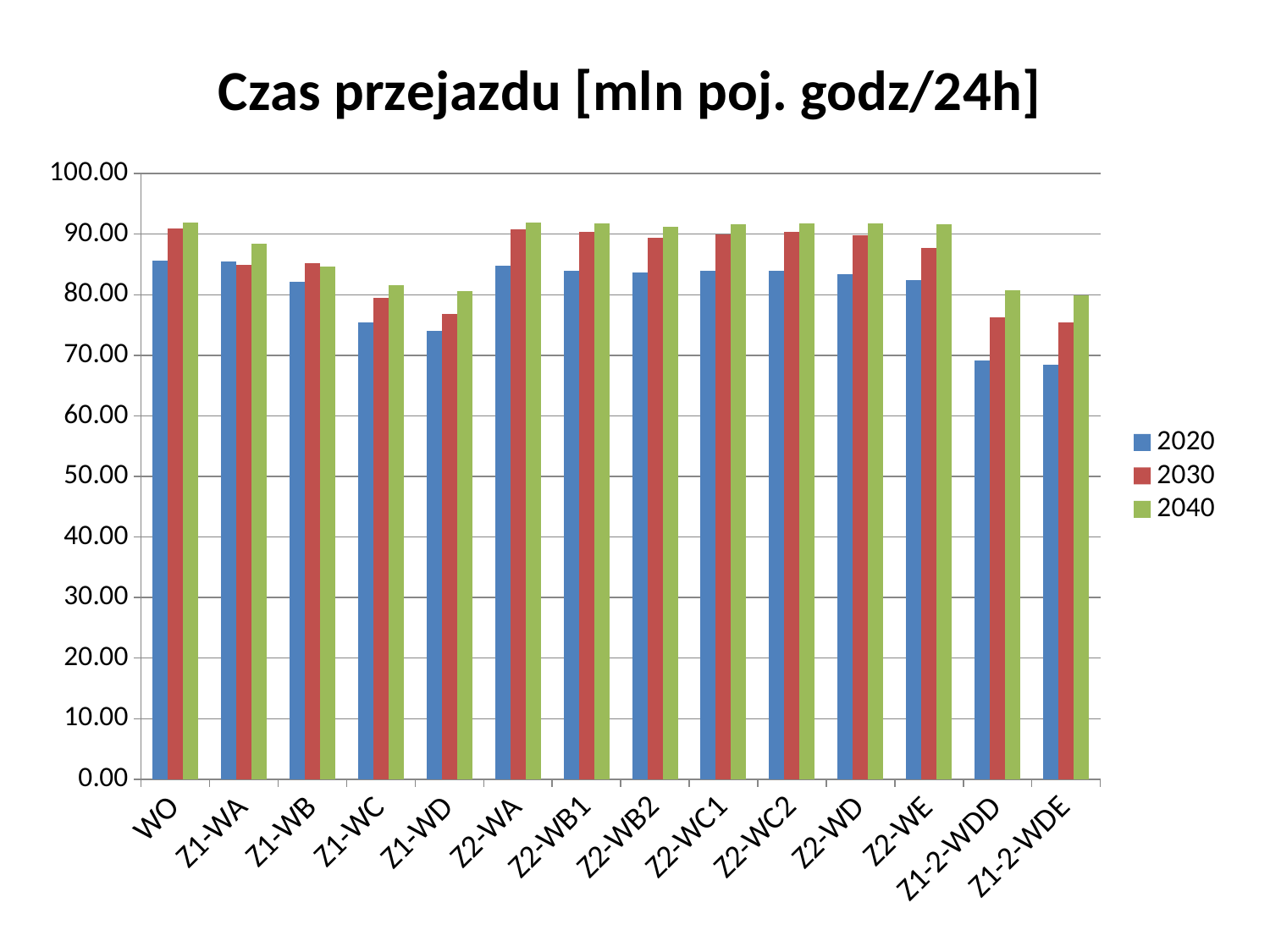
What is the title of the chart? Czas przejazdu [mln poj. godz/24h] Is the 2040 value for WO greater or less than 90.00? greater Is the 2030 value for Z2-WE greater or less than 90.00? less Which series is shown in green? 2040 How many categories are shown on the x axis? 14 Which is larger, the 2040 value for WO or the 2040 value for Z1-WA? WO Is the 2030 value for Z1-WD greater or less than 80.00? less How many series does the legend list? 3 Which is larger, the 2030 value for Z1-WB or the 2030 value for Z1-WC? Z1-WB What kind of chart is shown on the slide? bar chart